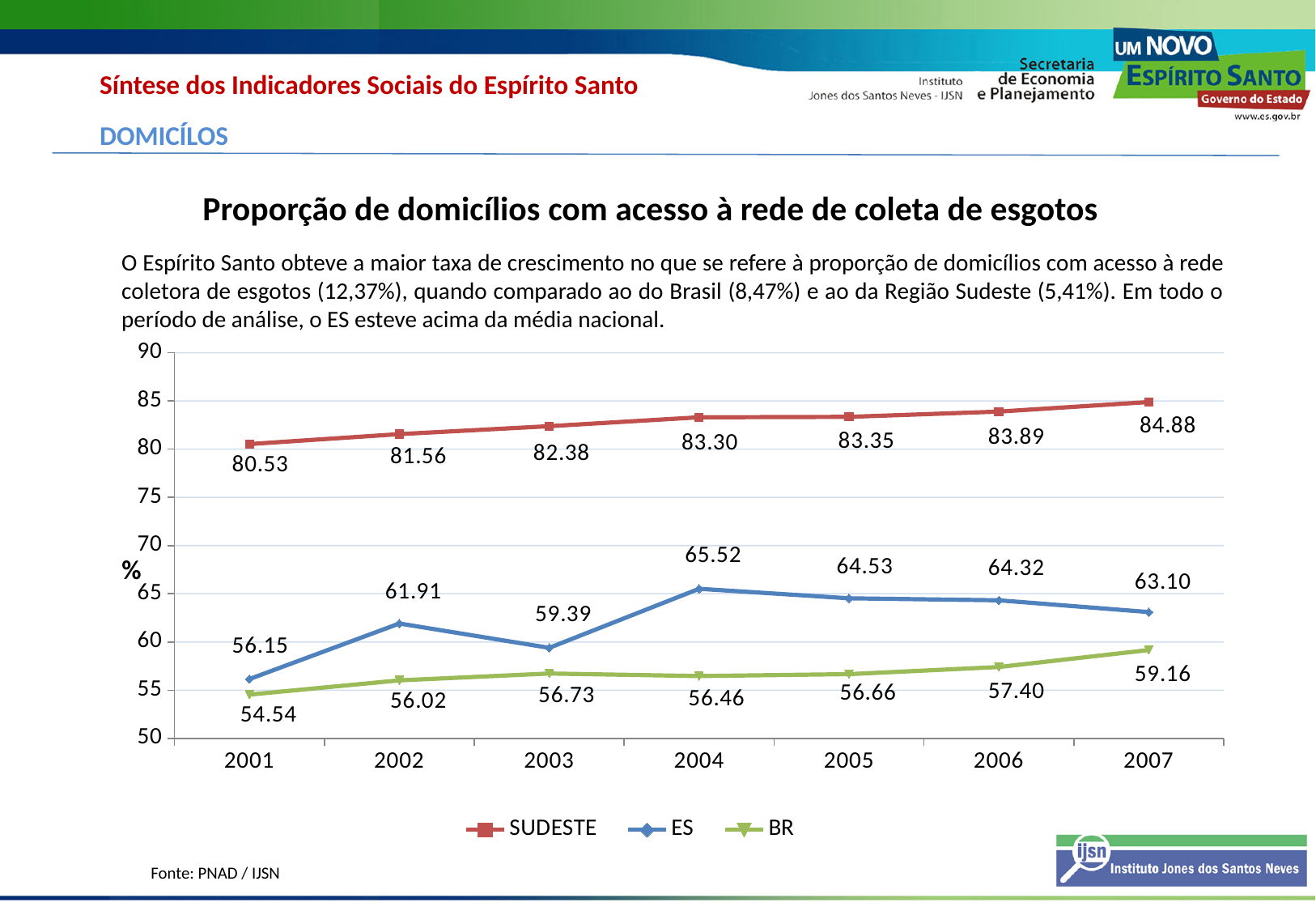
What is the value for SUDESTE in 2001? 80.53 What is the value for BR in 2007? 59.16 Is the SUDESTE value in 2007 greater or less than 80? greater Which is larger in 2003, the ES value or the BR value? ES In which year is the BR series at its lowest? 2001 Does the SUDESTE series rise or fall from 2001 to 2007? rise How many series does the legend list? 3 What is the difference between the ES value and the BR value in 2007? 3.94 What kind of chart is shown? line chart In which year is the ES series at its highest? 2004 What is the value for ES in 2004? 65.52 How many years are shown on the x axis? 7